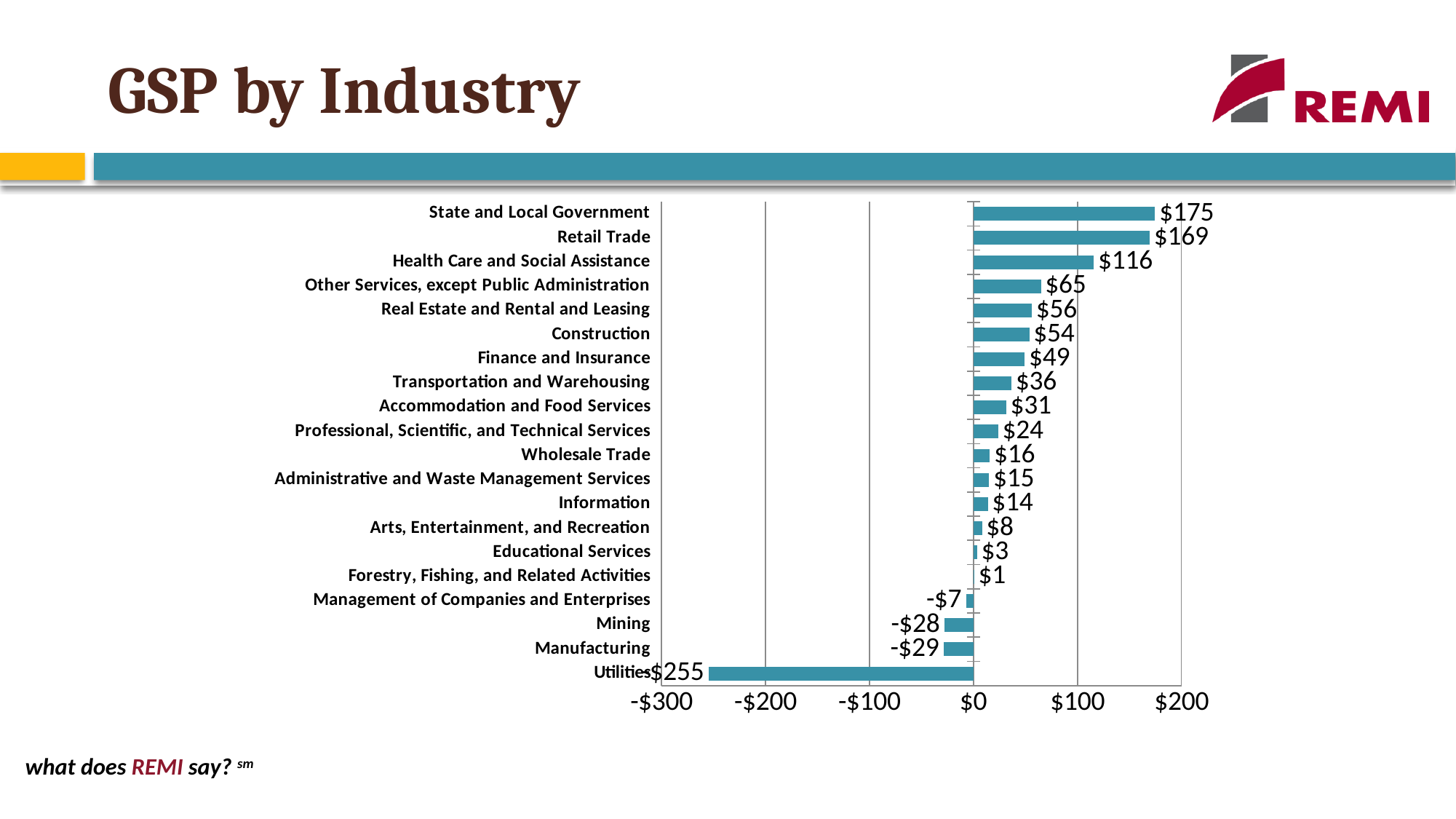
What is the value for Manufacturing? -$29 How many industries are shown in the chart? 20 Which industry has the lowest value? Utilities Which industry has the highest value? State and Local Government What is the value for Management of Companies and Enterprises? -$7 What is the value for State and Local Government? $175 Which is larger, the value for Construction or the value for Finance and Insurance? Construction Is the value for Utilities greater or less than -$200? less What is the difference between the values for State and Local Government and Retail Trade? $6 What is the value for Health Care and Social Assistance? $116 What kind of chart is shown on the slide? bar chart What is the title of the slide? GSP by Industry